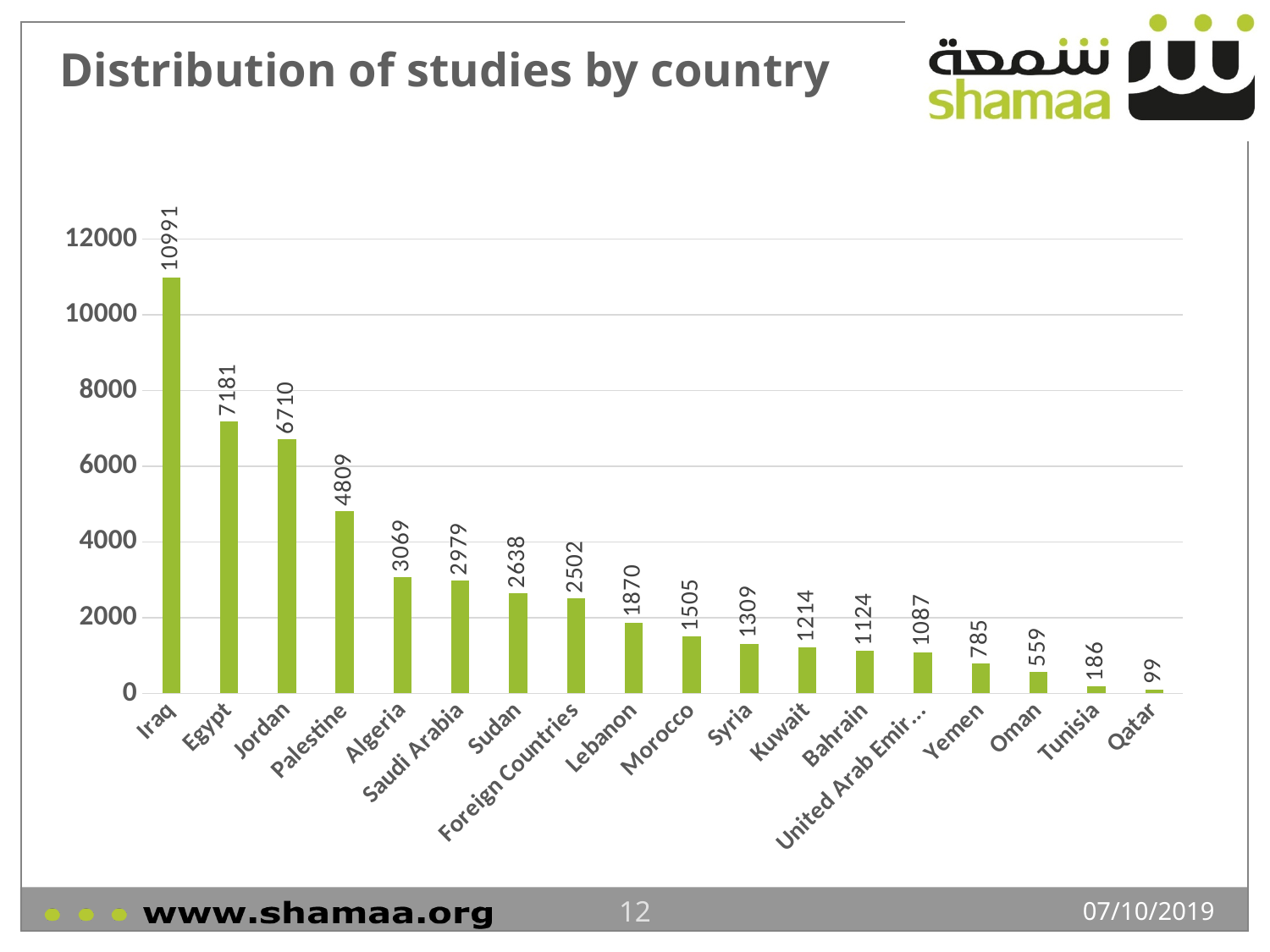
What is the number of studies for Tunisia? 186 How many countries/categories are shown in the chart? 18 Which has more studies, Algeria or Saudi Arabia? Algeria Is the value for Morocco greater or less than 2000? less What kind of chart is shown on the slide? Bar chart What is the title of the slide? Distribution of studies by country Which country has the lowest number of studies? Qatar What is the number of studies for Lebanon? 1870 What is the number of studies for Palestine? 4809 Which country has the highest number of studies? Iraq What is the difference between the number of studies for Egypt and Jordan? 471 What is the number of studies for Iraq? 10991